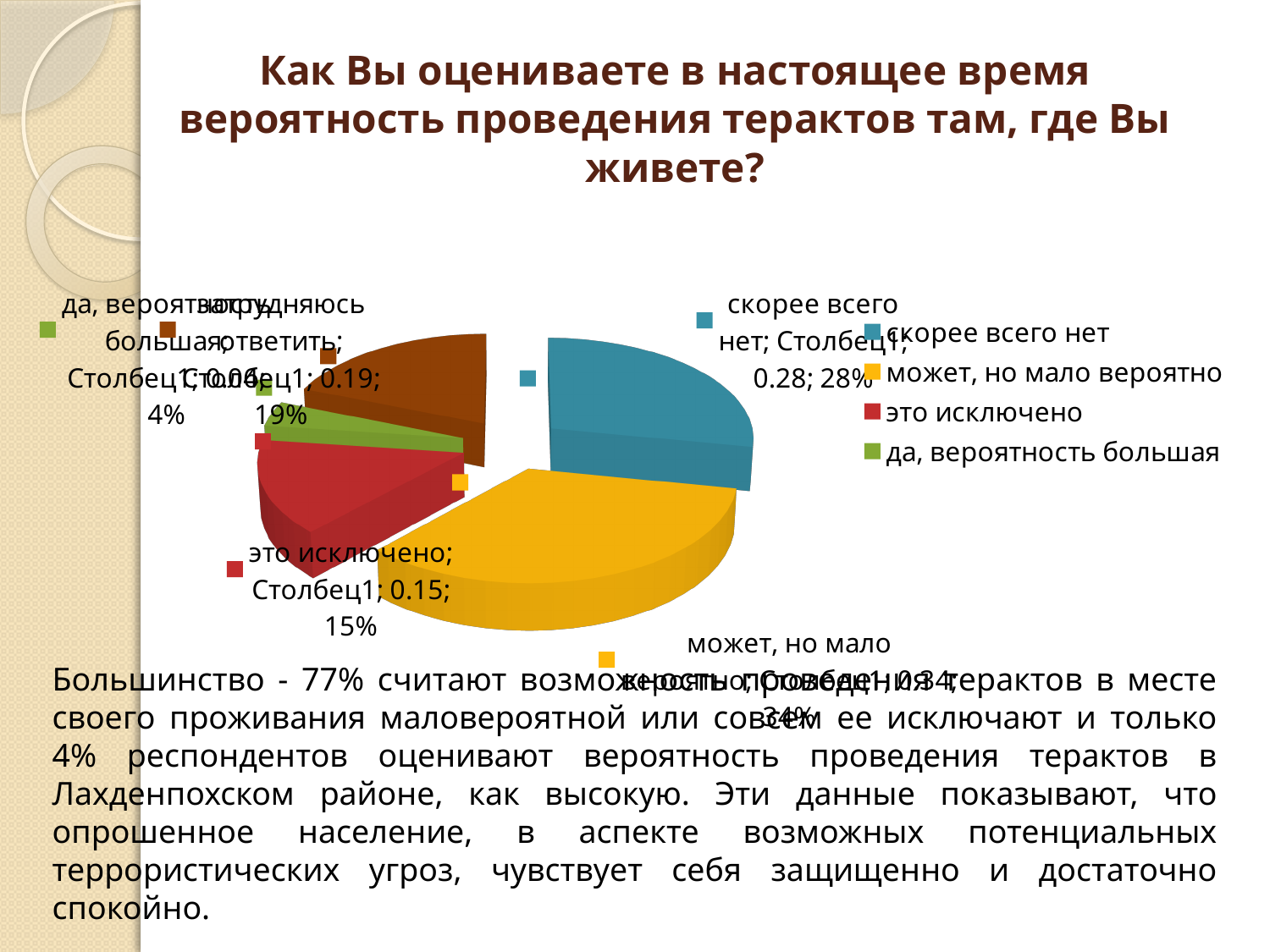
Which category has the largest share of the pie? может, но мало вероятно What colour is the slice for "может, но мало вероятно"? yellow What kind of chart is shown on the slide? pie chart Which is larger: the share for "это исключено" or the share for "затрудняюсь ответить"? затрудняюсь ответить How many entries does the legend list? 4 What percentage is shown for "может, но мало вероятно"? 34% What percentage is shown for "это исключено"? 15% What percentage is shown for "скорее всего нет"? 28% How many slices does the pie chart have? 5 What is the difference in percentage points between "может, но мало вероятно" and "скорее всего нет"? 6 What percentage is shown for "затрудняюсь ответить"? 19% Which category has the smallest share of the pie? да, вероятность большая